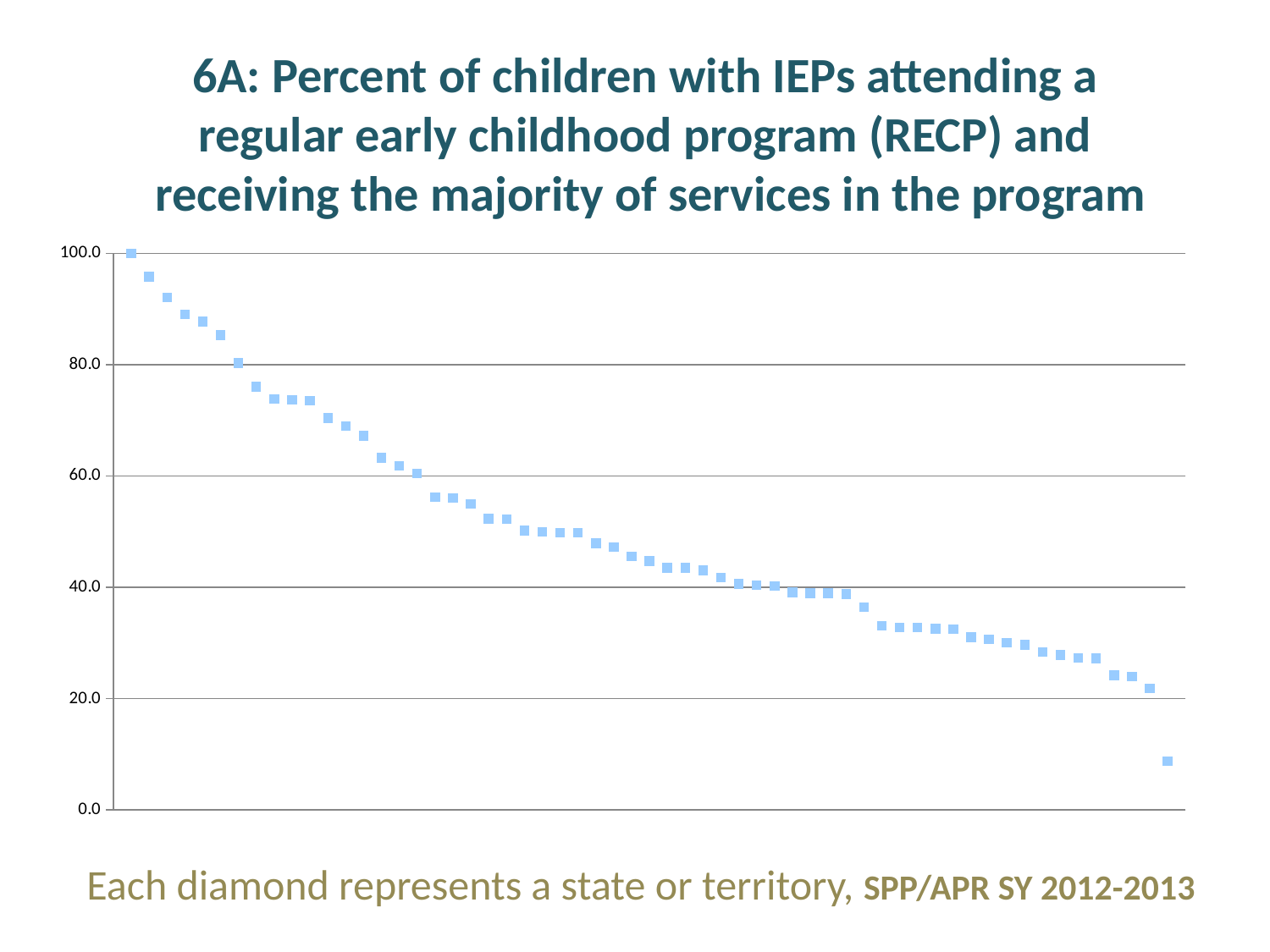
What kind of chart is shown on the slide? scatter chart Do the plotted values rise or fall from left to right along the x axis? fall Is the value of the second-highest point greater or less than 80.0? greater According to the caption below the chart, what does each diamond represent? a state or territory What is the maximum value shown on the vertical axis? 100.0 Is the value of the lowest point greater or less than 20.0? less Is the value of the second-lowest point greater or less than 40.0? less